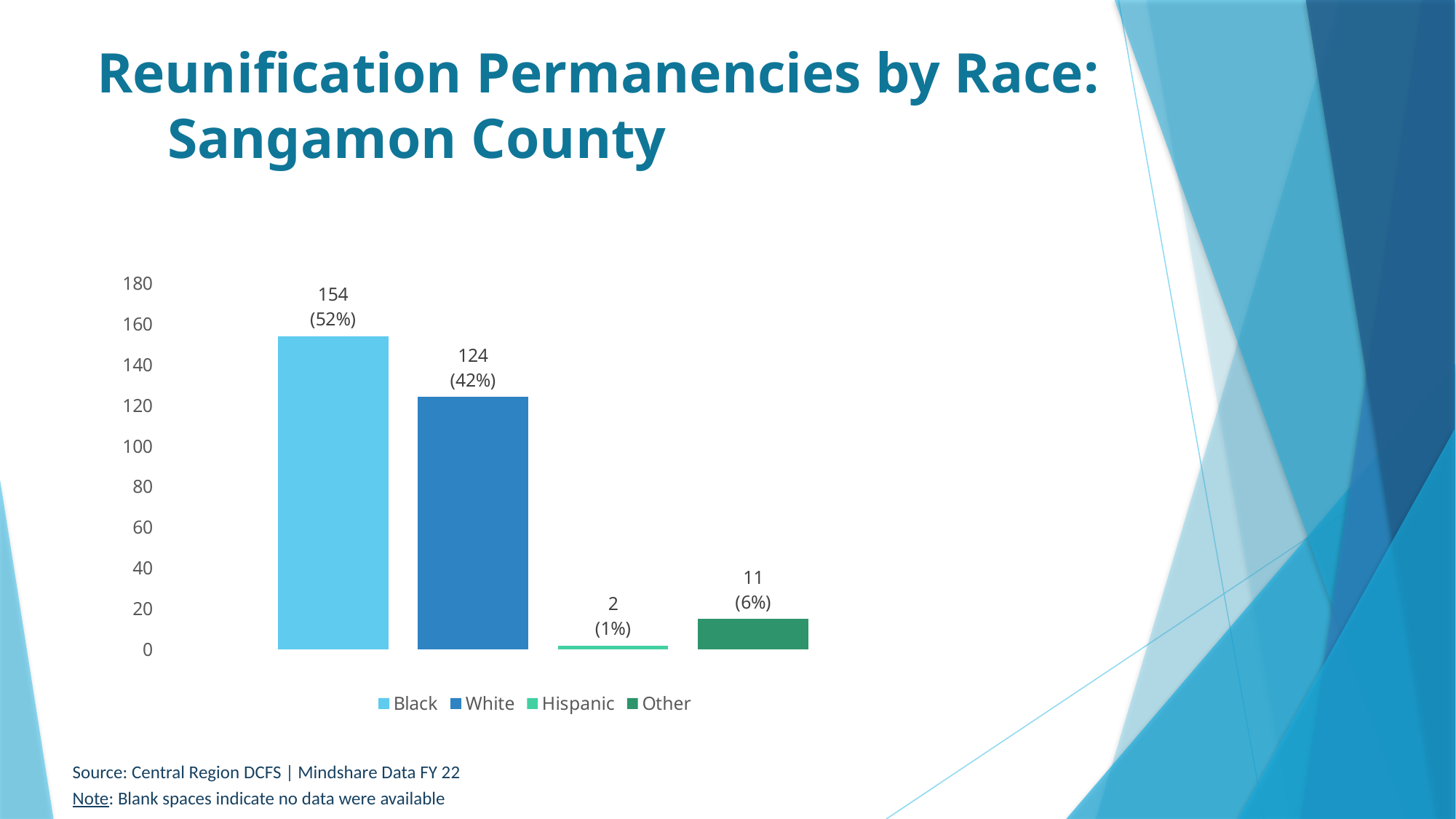
What is the value for Black? 154 What is the title of the slide? Reunification Permanencies by Race: Sangamon County What is the value for White? 124 What is the difference between the values for Black and White? 30 Which category has the highest value? Black Which category has the lowest value? Hispanic How many categories are plotted in the chart? 4 Is the value for White greater or less than 100? greater Which is larger, the value for Other or the value for Hispanic? Other What percentage is shown for Other? 6% What kind of chart is shown on the slide? bar chart What is the value for Hispanic? 2